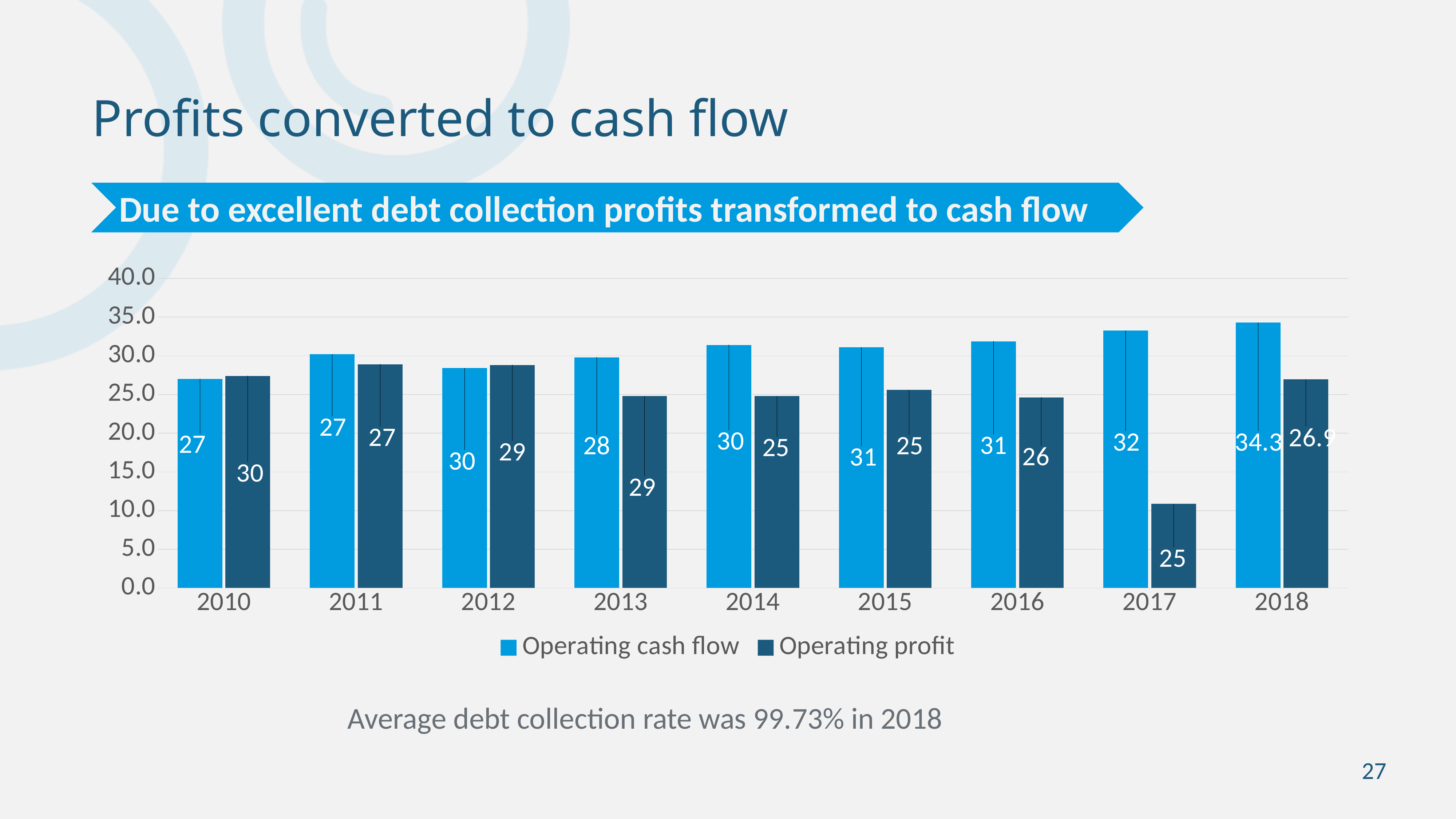
What is the difference between Operating cash flow and Operating profit in 2018? 7.4 What kind of chart is shown on the slide? Bar chart How many years are shown on the x axis? 9 How many series does the legend list? 2 In 2017, which is larger: Operating cash flow or Operating profit? Operating cash flow What is the Operating profit value for 2018? 26.9 Is the Operating cash flow value for 2018 greater or less than 30.0? greater What is the Operating cash flow value for 2015? 31 Which year has the highest Operating cash flow? 2018 What is the Operating cash flow value for 2018? 34.3